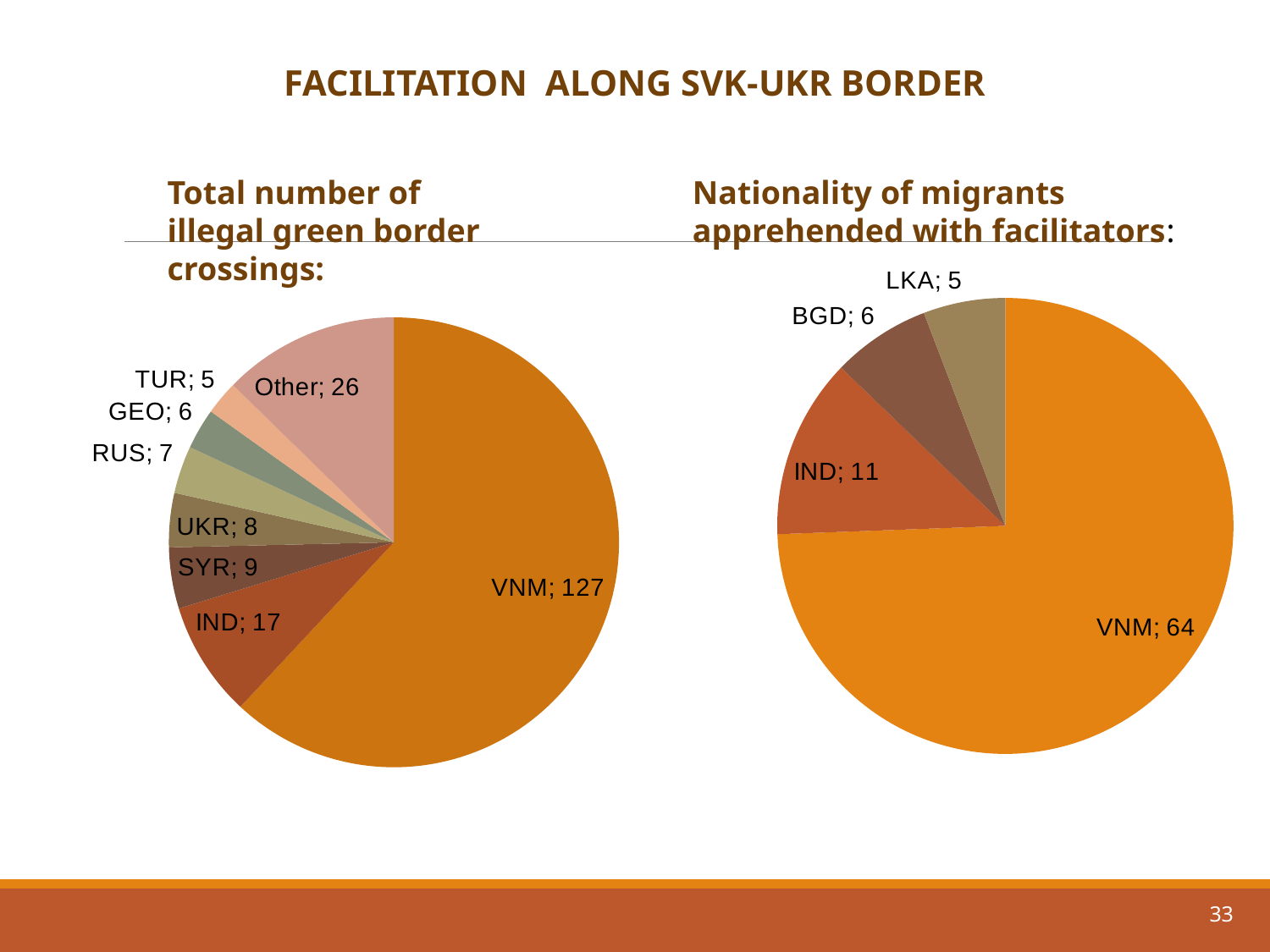
What kind of chart is used for the Nationality of migrants apprehended with facilitators? Pie chart In the left pie chart (Total number of illegal green border crossings), what is the difference between the values for VNM and IND? 110 What is the total of all slices in the right pie chart (Nationality of migrants apprehended with facilitators)? 86 In the left pie chart (Total number of illegal green border crossings), which is larger, the value for SYR or the value for RUS? SYR How many slices does the right pie chart (Nationality of migrants apprehended with facilitators) have? 4 In the right pie chart (Nationality of migrants apprehended with facilitators), which nationality has the largest slice? VNM In the left pie chart (Total number of illegal green border crossings), what is the value for Other? 26 In the left pie chart (Total number of illegal green border crossings), which category has the smallest slice? TUR How many slices does the left pie chart (Total number of illegal green border crossings) have? 8 In the right pie chart (Nationality of migrants apprehended with facilitators), what is the value for IND? 11 In the left pie chart (Total number of illegal green border crossings), what is the value for VNM? 127 In the right pie chart (Nationality of migrants apprehended with facilitators), what is the difference between the values for IND and BGD? 5